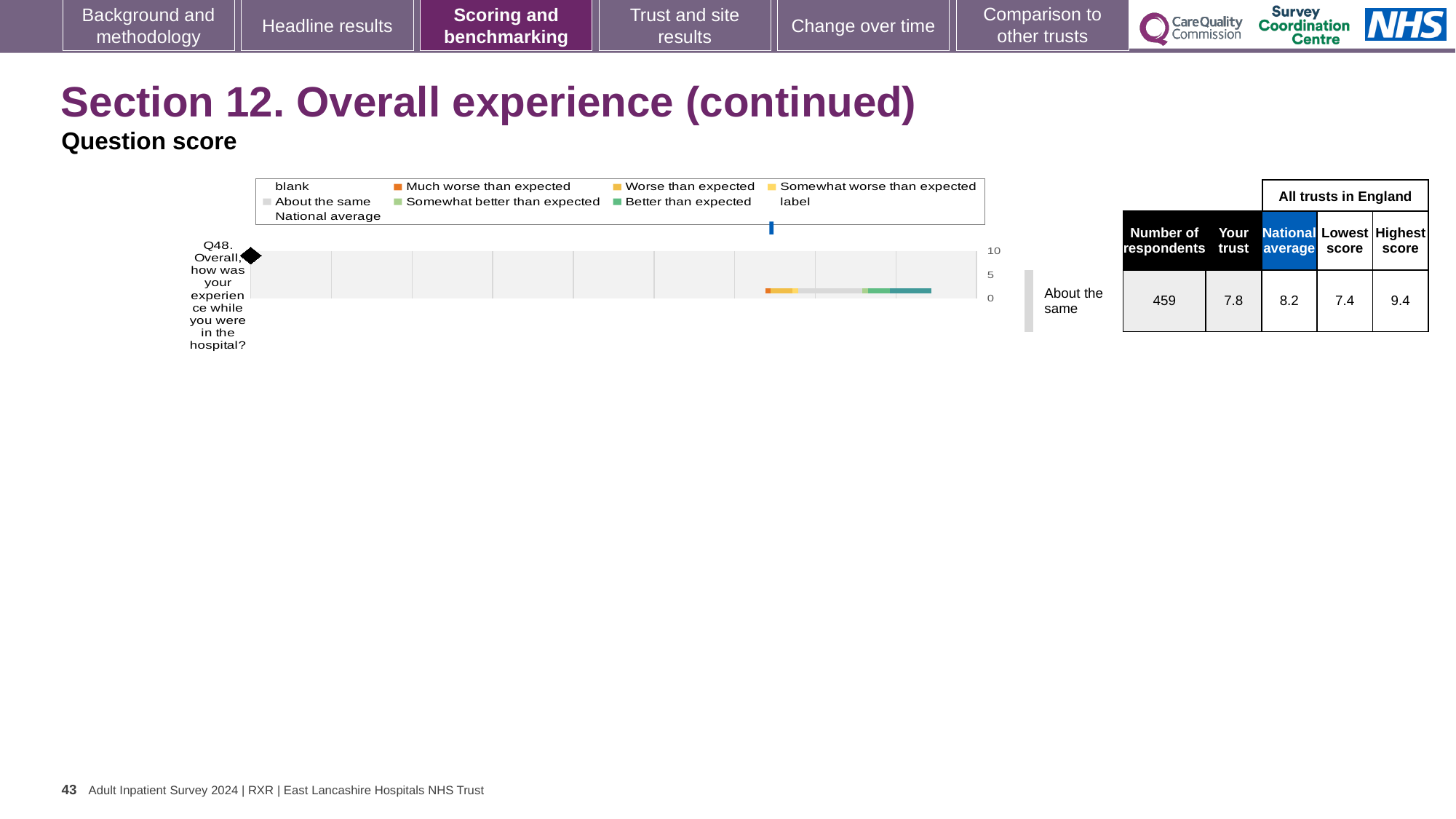
How many survey questions are plotted in the chart? 1 What is the highest tick value shown on the chart's score axis? 10 What is the lowest score among all trusts in England for Q48? 7.4 What is the national average score for Q48 shown in the table? 8.2 By how much does the national average exceed the 'Your trust' score for Q48? 0.4 How many respondents answered Q48? 459 What is the 'Your trust' score for Q48 shown in the table next to the chart? 7.8 Which is larger for Q48, the 'Your trust' score or the national average? National average Which benchmarking category is the trust's Q48 score placed in? About the same What is the difference between the highest score and the lowest score for Q48? 2.0 What kind of chart is shown for Q48 on the slide? bar chart What is the highest score among all trusts in England for Q48? 9.4